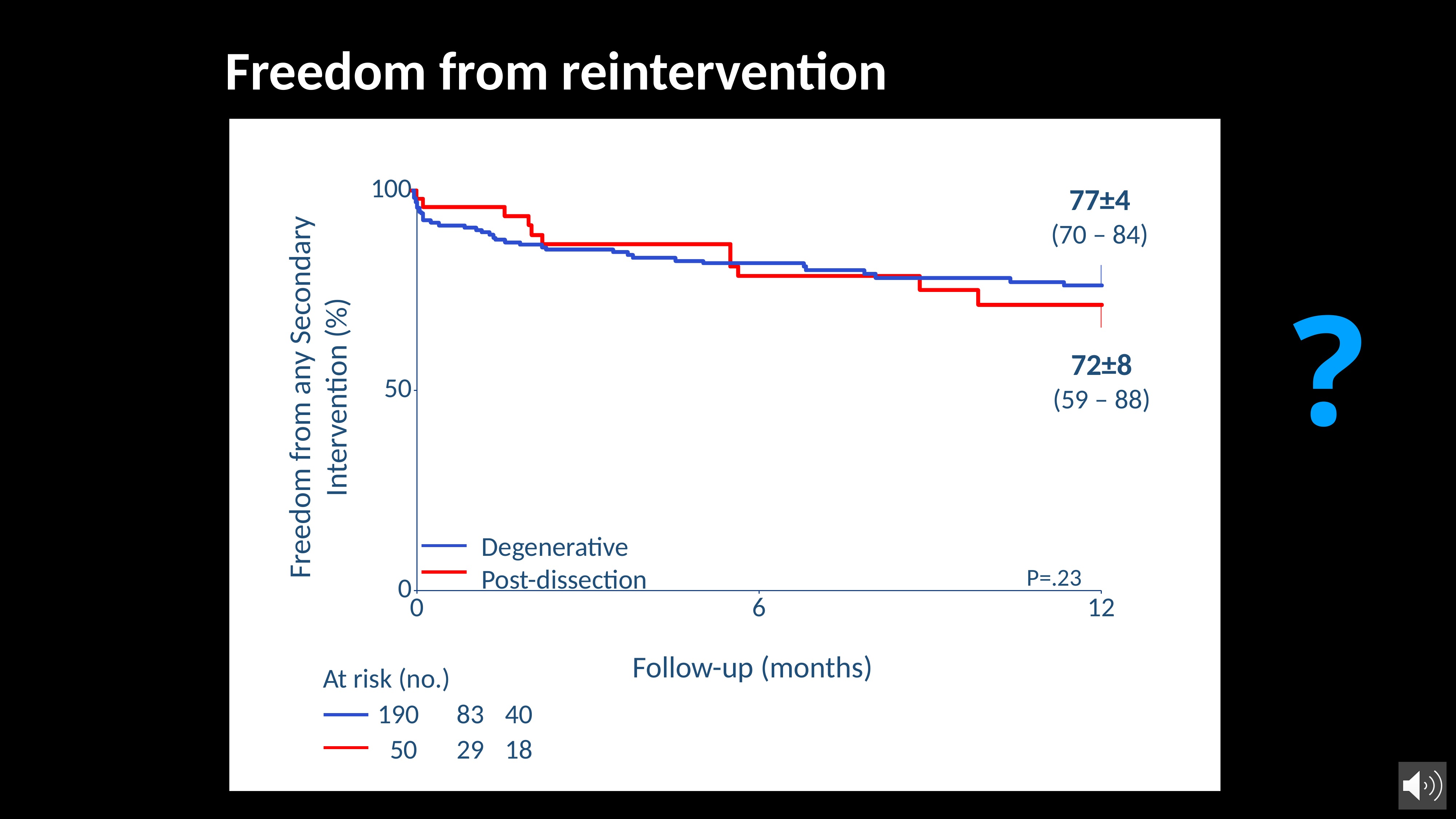
What is the freedom from secondary intervention at 12 months for the Post-dissection group? 72±8 Do the curves rise or fall as follow-up months increase? Fall How many series does the legend list? 2 How many Post-dissection patients were at risk at the last time point in the at-risk table? 18 What is the confidence interval shown for the Post-dissection group at 12 months? (59 – 88) Which group has the higher freedom from secondary intervention at 12 months, Degenerative or Post-dissection? Degenerative Which series is drawn in red? Post-dissection What kind of chart is shown on the slide? Line chart (Kaplan-Meier curve) How many Degenerative patients were at risk at the start of follow-up? 190 What is the confidence interval shown for the Degenerative group at 12 months? (70 – 84) What is the freedom from secondary intervention at 12 months for the Degenerative group? 77±4 What P value is shown on the chart? P=.23